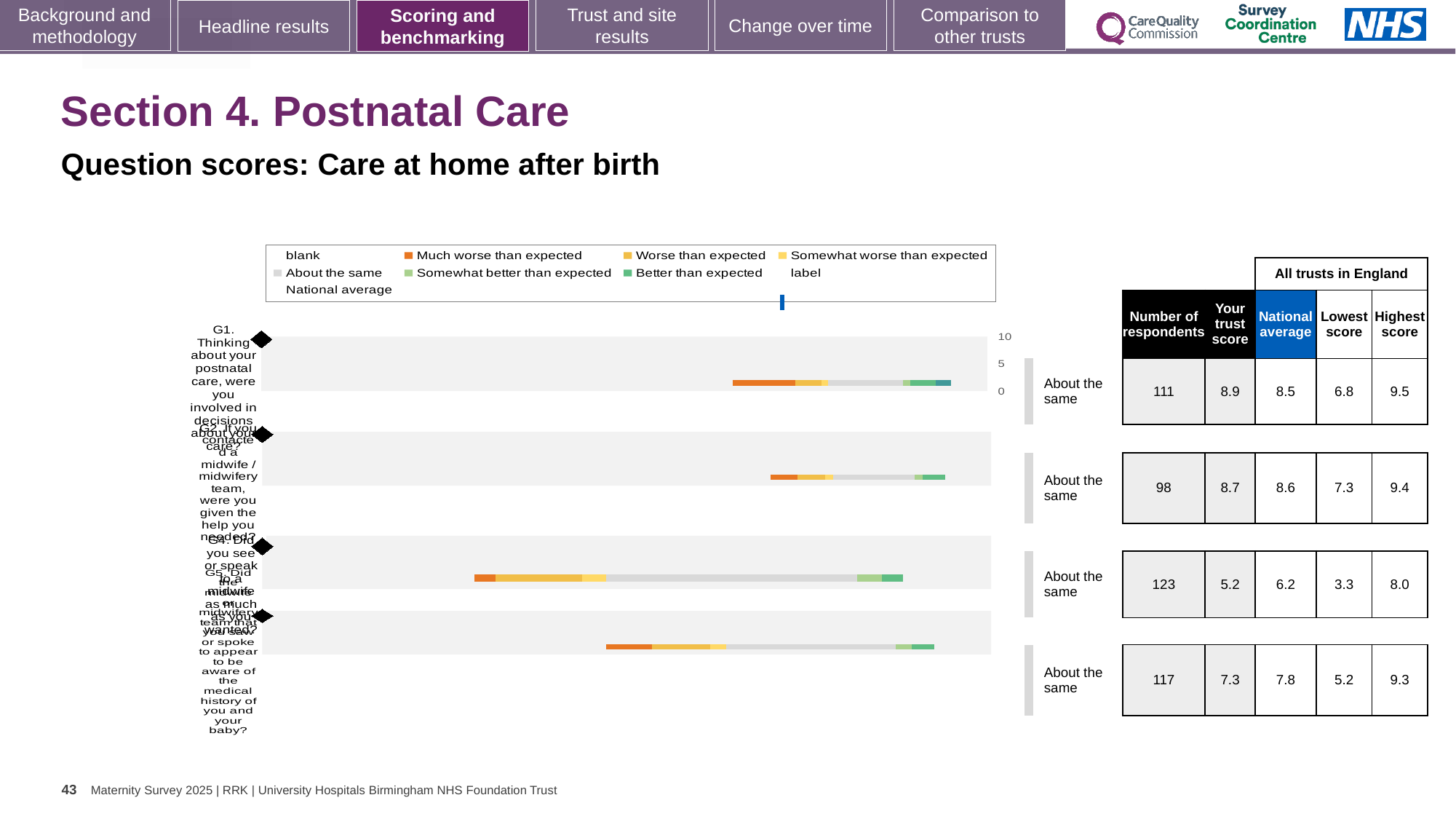
How many respondents answered question G4 (third row)? 123 Which question has the lowest trust score? G4 What is the highest score among all trusts in England for question G5 (fourth row)? 9.3 What is the difference between the trust score and the national average for question G1? 0.4 What is the national average for question G2 (given the help you needed when contacting a midwife)? 8.6 For question G4, is the trust score or the national average larger? National average What is the difference between the highest score and the lowest score for question G4? 4.7 What is the trust score for question G1 (involved in decisions about postnatal care)? 8.9 How many questions (categories) are plotted in the chart? 4 What benchmark category is shown for question G2? About the same Which question has the highest trust score? G1 What kind of chart is shown on the slide? bar chart